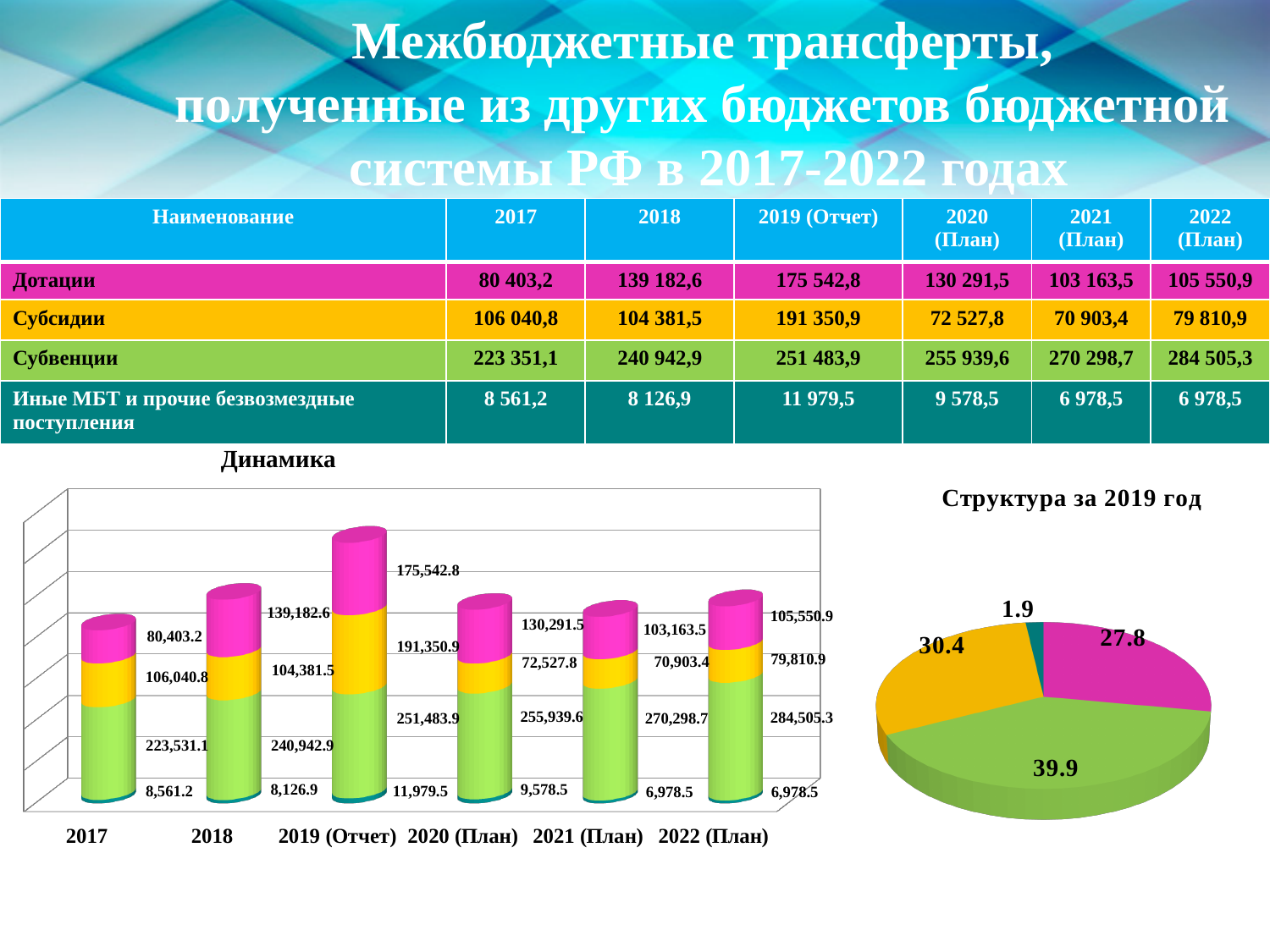
What kind of chart is the "Динамика" chart? bar chart How many year categories are shown on the x axis of the "Динамика" chart? 6 In the "Динамика" chart, what is the value of the green segment for 2022 (План)? 284,505.3 In the "Динамика" chart, does the green segment rise or fall from 2017 to 2022 (План)? rise In the "Динамика" chart, what is the total of the stacked bar for 2017? 418,536.3 What kind of chart is "Структура за 2019 год"? pie chart In the "Динамика" chart, what is the value of the pink (top) segment for 2019 (Отчет)? 175,542.8 In the "Динамика" chart, what is the difference between the pink segment values for 2019 (Отчет) and 2018? 36,360.2 In the "Структура за 2019 год" pie chart, what is the value of the largest slice? 39.9 In the "Динамика" chart, which year has the largest green segment? 2022 (План) In the "Динамика" chart, what is the value of the smallest (bottom) segment for 2019 (Отчет)? 11,979.5 In the "Динамика" chart, is the yellow segment larger in 2017 or in 2018? 2017